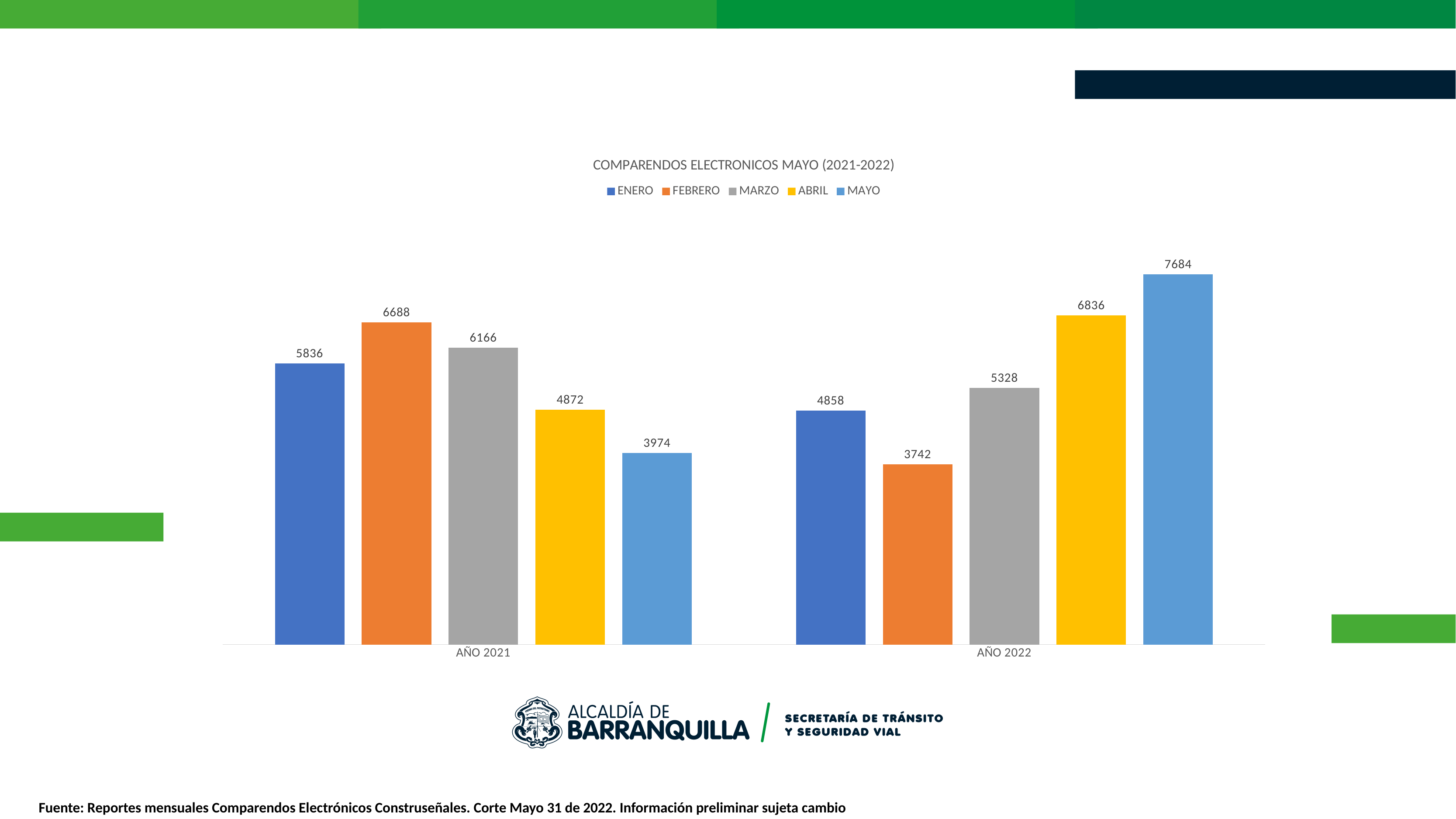
What is the difference between the MAYO values for AÑO 2022 and AÑO 2021? 3710 What kind of chart is shown on the slide? Bar chart What is the value for ABRIL in AÑO 2022? 6836 What is the value for FEBRERO in AÑO 2021? 6688 Which month has the lowest value in AÑO 2022? FEBRERO What is the value for MAYO in AÑO 2022? 7684 What is the title of the chart? COMPARENDOS ELECTRONICOS MAYO (2021-2022) Which month has the highest value in AÑO 2021? FEBRERO What is the difference between ENERO in AÑO 2021 and ENERO in AÑO 2022? 978 Which is larger: MARZO in AÑO 2021 or MARZO in AÑO 2022? MARZO in AÑO 2021 How many series does the legend list? 5 How many categories are shown on the x axis? 2